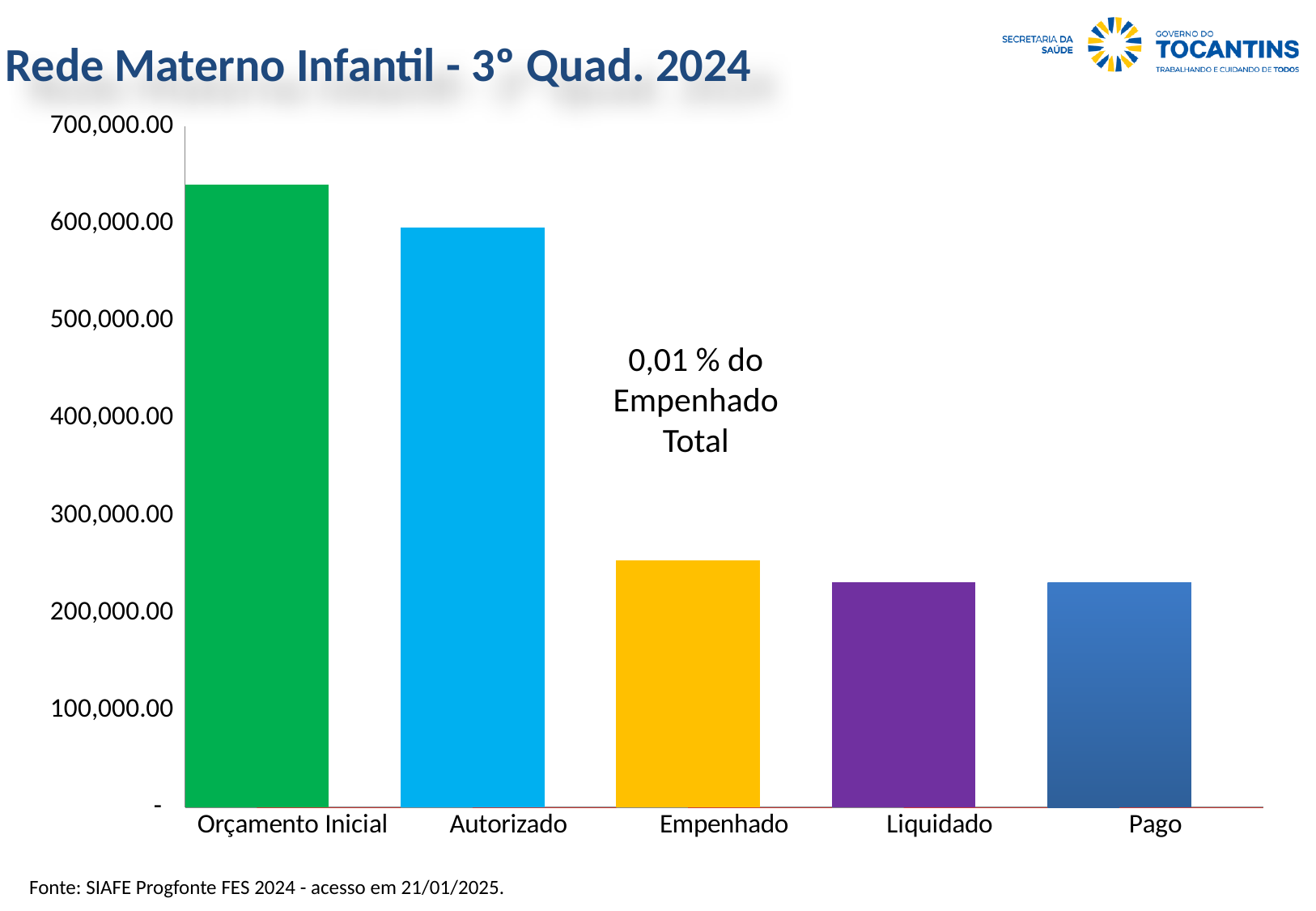
How many categories are plotted on the x axis? 5 Which is larger, the value for Empenhado or the value for Liquidado? Empenhado Do the values generally rise or fall from left to right along the x axis? fall Is the value for Empenhado greater or less than 300,000.00? less Is the value for Pago greater or less than 300,000.00? less Which category has the highest value? Orçamento Inicial What kind of chart is shown on the slide? bar chart What is the title of the chart? Rede Materno Infantil - 3° Quad. 2024 Which is larger, the value for Orçamento Inicial or the value for Autorizado? Orçamento Inicial Is the value for Orçamento Inicial greater or less than 600,000.00? greater